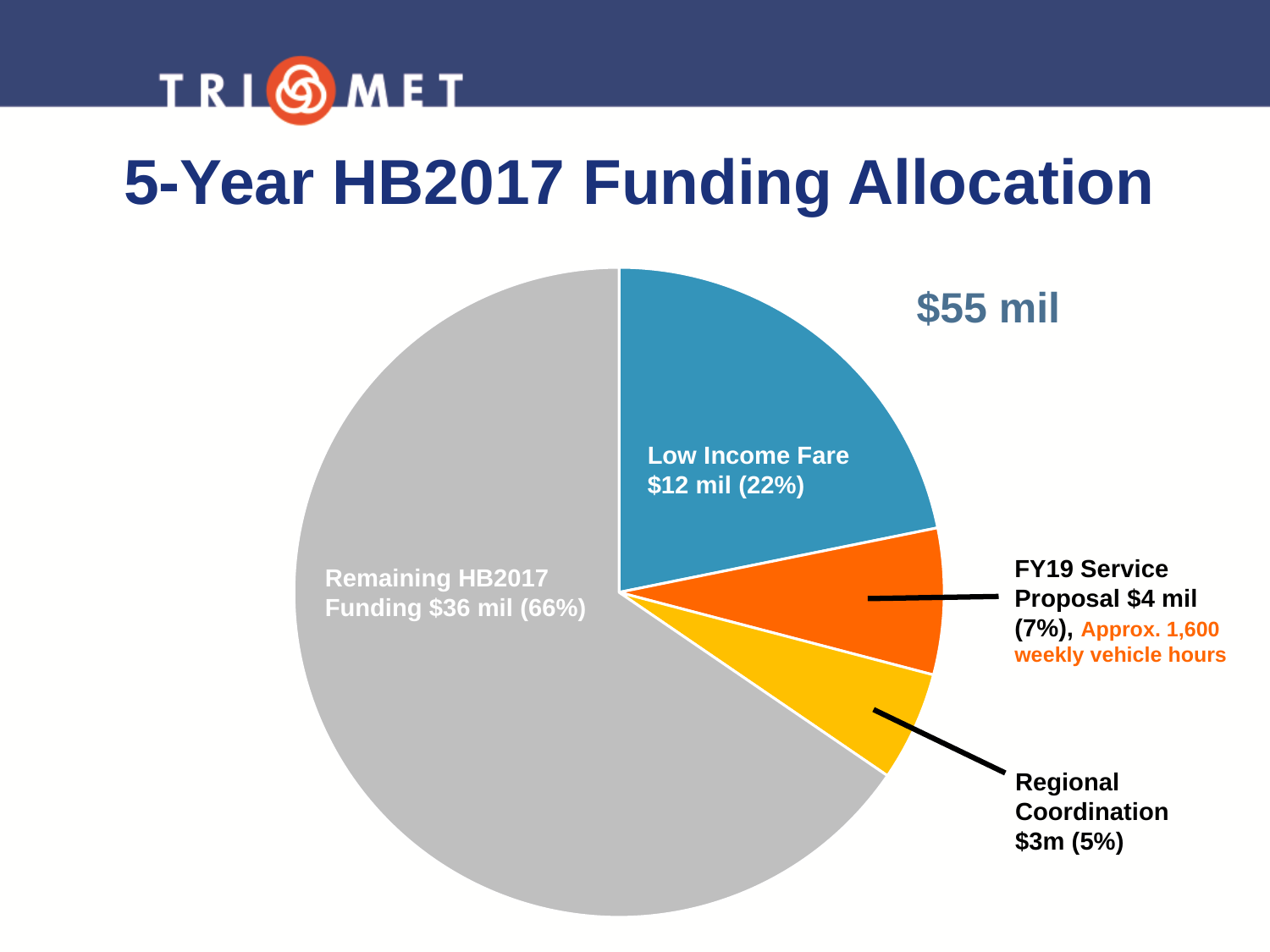
Which is larger, FY19 Service Proposal or Regional Coordination? FY19 Service Proposal Which slice is the smallest? Regional Coordination What share of the pie is Low Income Fare? 22% What is the value for FY19 Service Proposal? $4 mil What is the title of the chart? 5-Year HB2017 Funding Allocation Which slice is the largest? Remaining HB2017 Funding What kind of chart is shown on the slide? pie chart What is the value for Remaining HB2017 Funding? $36 mil What is the difference between Low Income Fare and FY19 Service Proposal in millions of dollars? $8 mil What share of the pie is Regional Coordination? 5% How many slices does the pie chart have? 4 What is the value for Low Income Fare? $12 mil